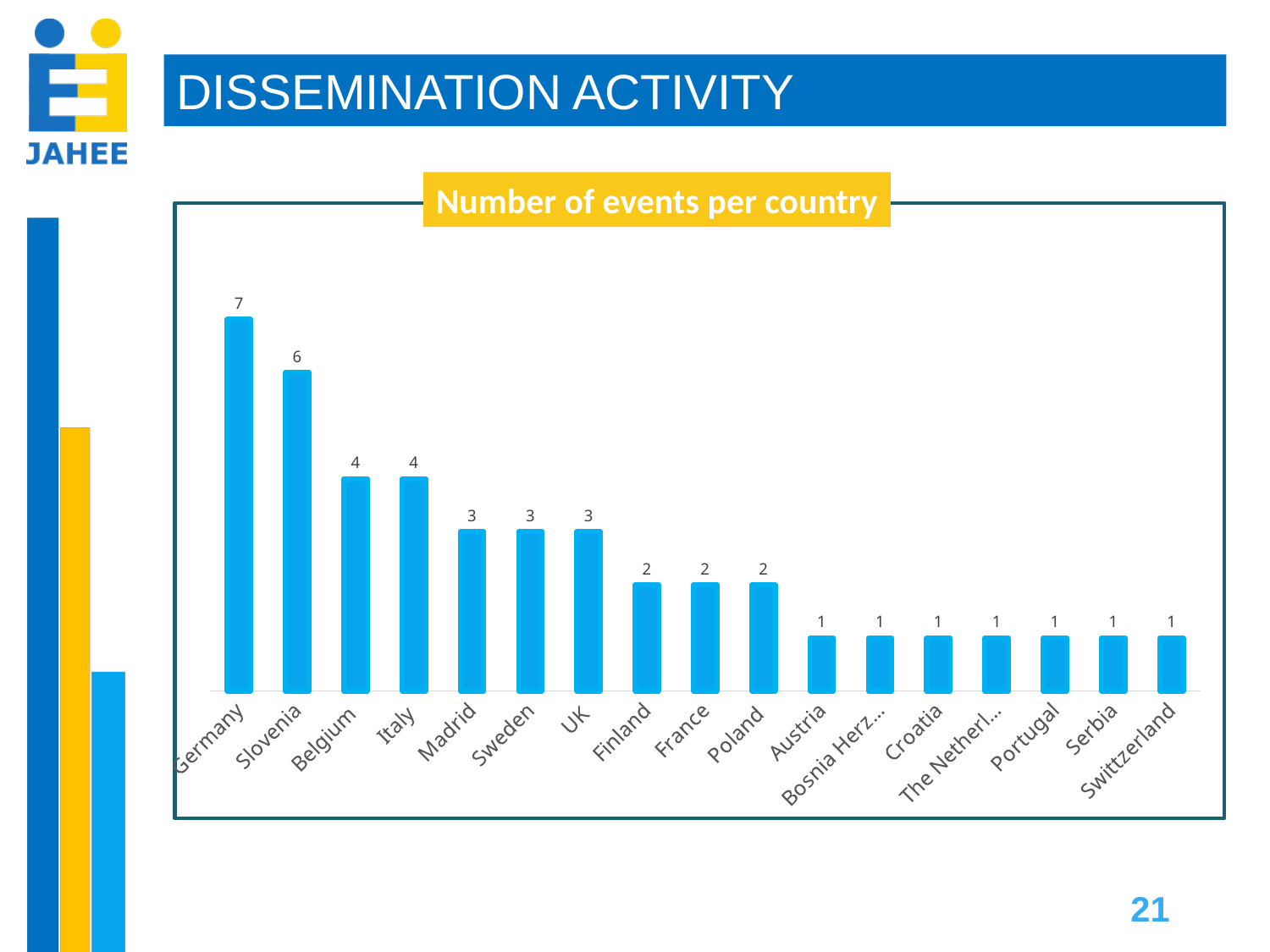
Which has more events, Italy or UK? Italy What is the difference in number of events between Germany and Belgium? 3 How many categories are shown on the x axis of the chart? 17 What is the number of events for Germany? 7 What is the number of events for Madrid? 3 What kind of chart is shown on the slide? Bar chart Which has more events, Slovenia or Sweden? Slovenia What is the difference in number of events between Slovenia and Finland? 4 What is the number of events for Poland? 2 What is the number of events for Slovenia? 6 What is the title of the chart? Number of events per country Which country has the highest number of events? Germany